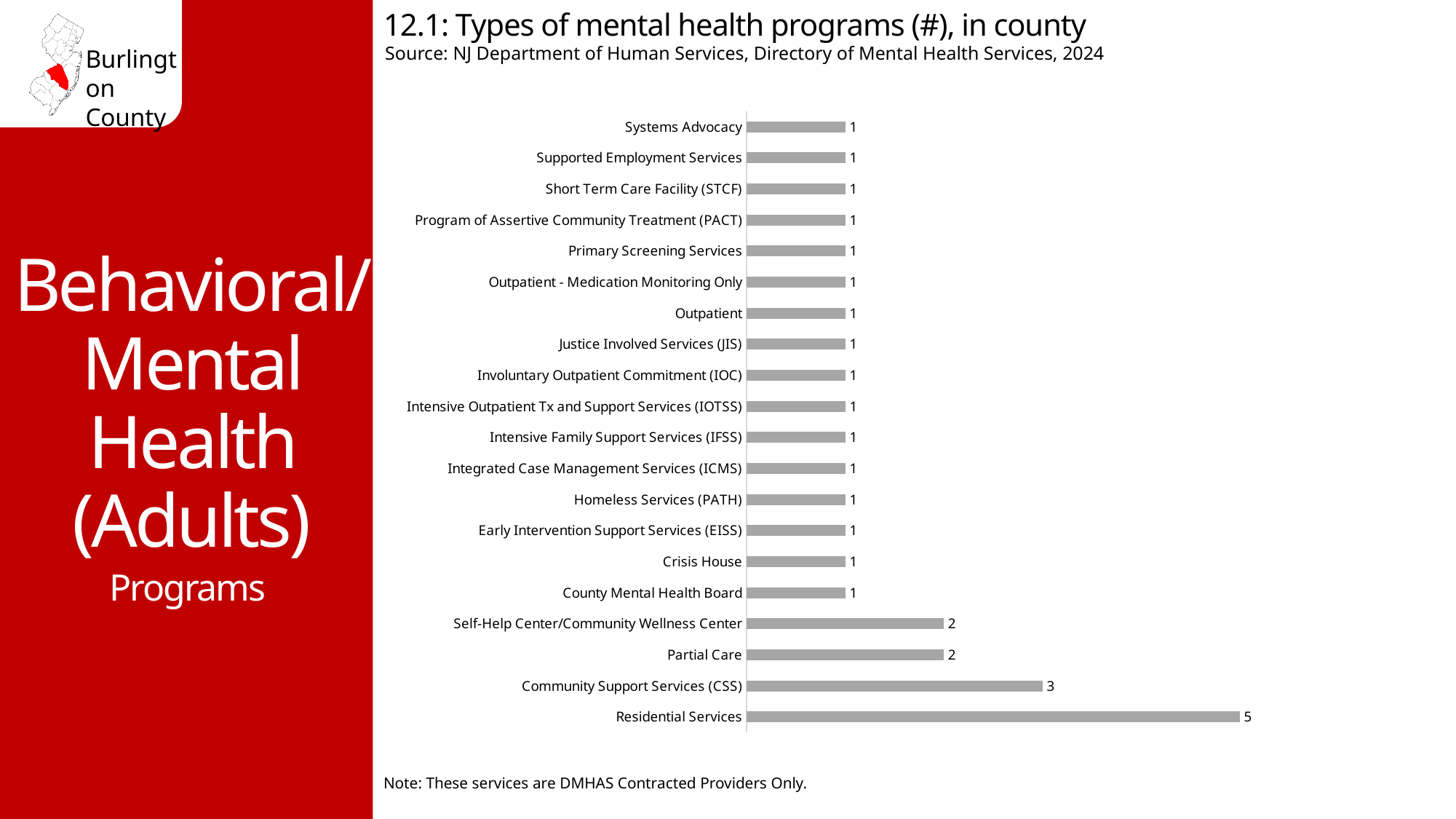
What value is shown for Partial Care? 2 How many Community Support Services (CSS) programs are shown? 3 What is the number of Residential Services programs shown on the chart? 5 Which has more programs, Partial Care or Outpatient? Partial Care How many types of mental health programs are listed on the chart? 20 What value is shown for Crisis House? 1 Which type of mental health program has the highest count? Residential Services What is the title of the chart? 12.1: Types of mental health programs (#), in county What is the difference between the number of Residential Services programs and Community Support Services (CSS) programs? 2 Which has more programs, Community Support Services (CSS) or Self-Help Center/Community Wellness Center? Community Support Services (CSS) What is the difference between the value for Self-Help Center/Community Wellness Center and the value for Systems Advocacy? 1 What kind of chart is shown on the slide? Bar chart